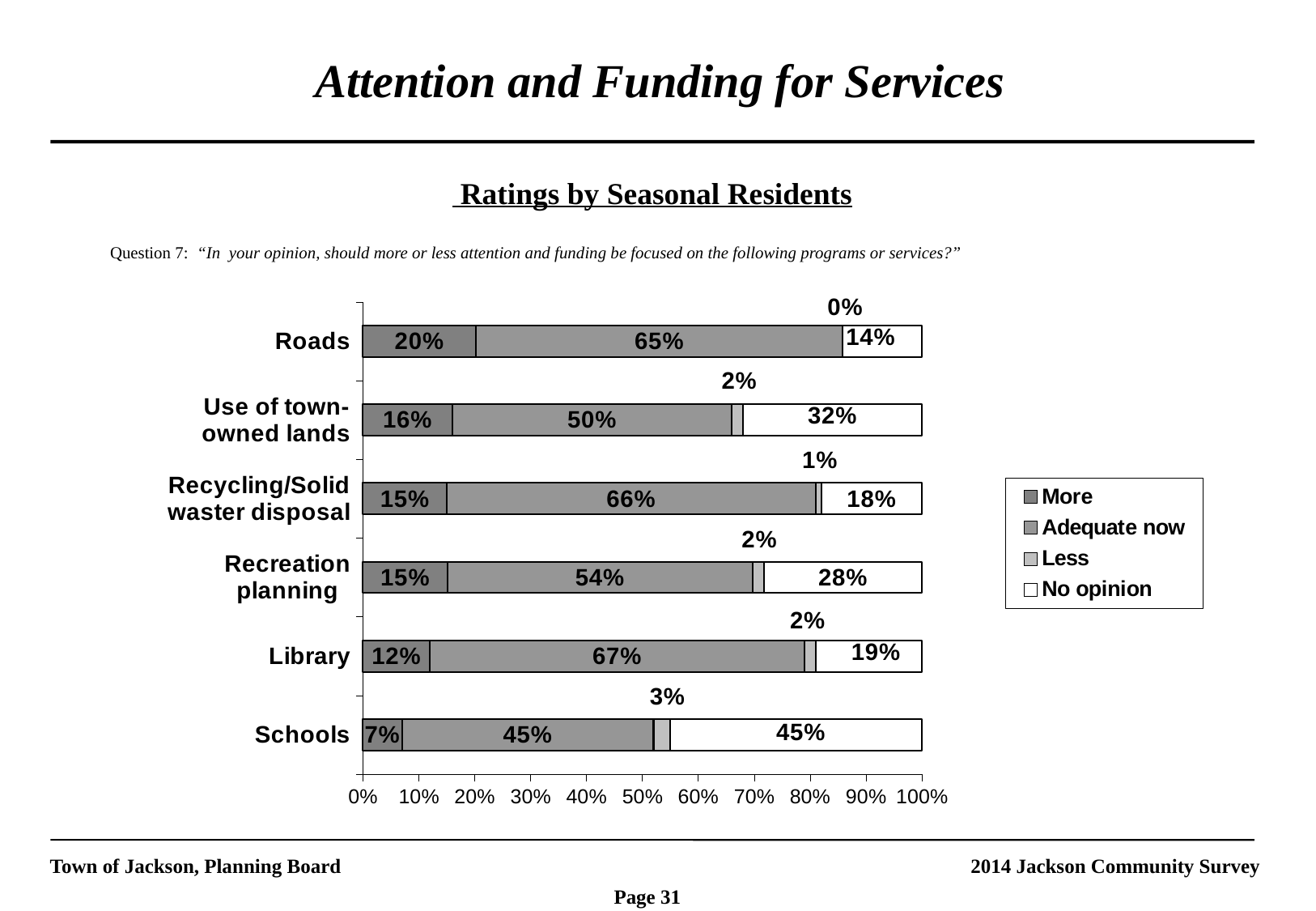
What percentage of seasonal residents said 'More' attention and funding should go to Roads? 20% How many services are listed on the chart? 6 Which has a larger 'Adequate now' value, Recreation planning or Recycling/Solid waster disposal? Recycling/Solid waster disposal What is the difference between the 'No opinion' values for Use of town-owned lands and Roads? 18% Which service has the lowest 'More' percentage? Schools How many series does the legend list? 4 What is the total of the labelled segments for the Schools bar? 100% What is the 'No opinion' value for Schools? 45% What kind of chart is shown on the slide? Stacked bar chart Which service has the highest 'More' percentage? Roads What is the 'Less' value for Recycling/Solid waster disposal? 1% What is the 'Adequate now' value for Library? 67%